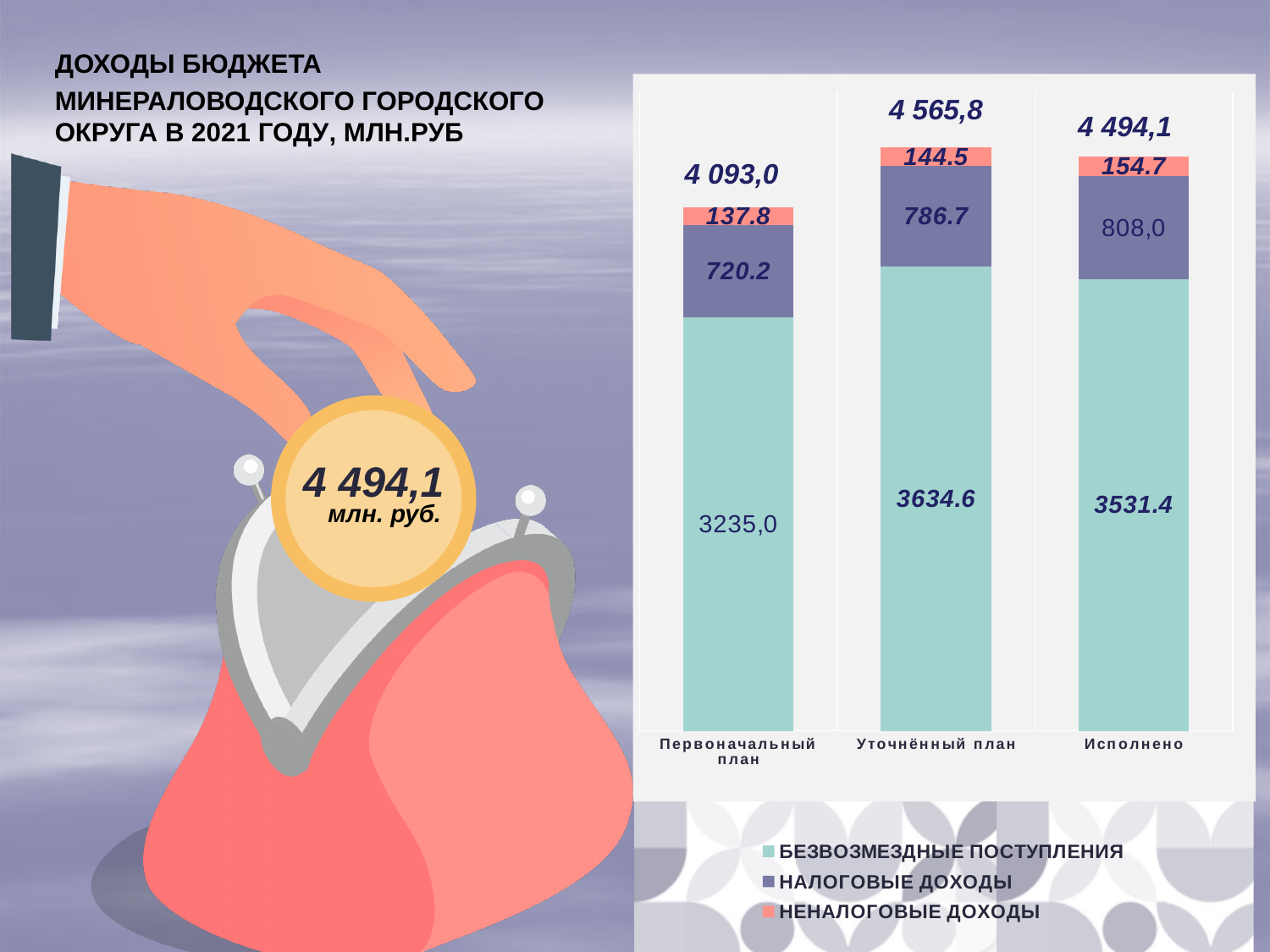
What is the value of НАЛОГОВЫЕ ДОХОДЫ for Уточнённый план? 786.7 Which category has the lowest value for НАЛОГОВЫЕ ДОХОДЫ? Первоначальный план How many categories are shown on the x axis of the chart? 3 Which is larger: БЕЗВОЗМЕЗДНЫЕ ПОСТУПЛЕНИЯ for Уточнённый план or for Исполнено? Уточнённый план How many series does the chart legend list? 3 What is the value of БЕЗВОЗМЕЗДНЫЕ ПОСТУПЛЕНИЯ for Первоначальный план? 3235,0 What type of chart is shown on the slide? Stacked bar chart What is the difference between НЕНАЛОГОВЫЕ ДОХОДЫ for Уточнённый план and for Первоначальный план? 6.7 Which category has the highest total? Уточнённый план Which series is shown in the teal colour at the bottom of each bar? БЕЗВОЗМЕЗДНЫЕ ПОСТУПЛЕНИЯ What is the value of НЕНАЛОГОВЫЕ ДОХОДЫ for Исполнено? 154.7 What is the total shown above the Уточнённый план bar? 4 565,8